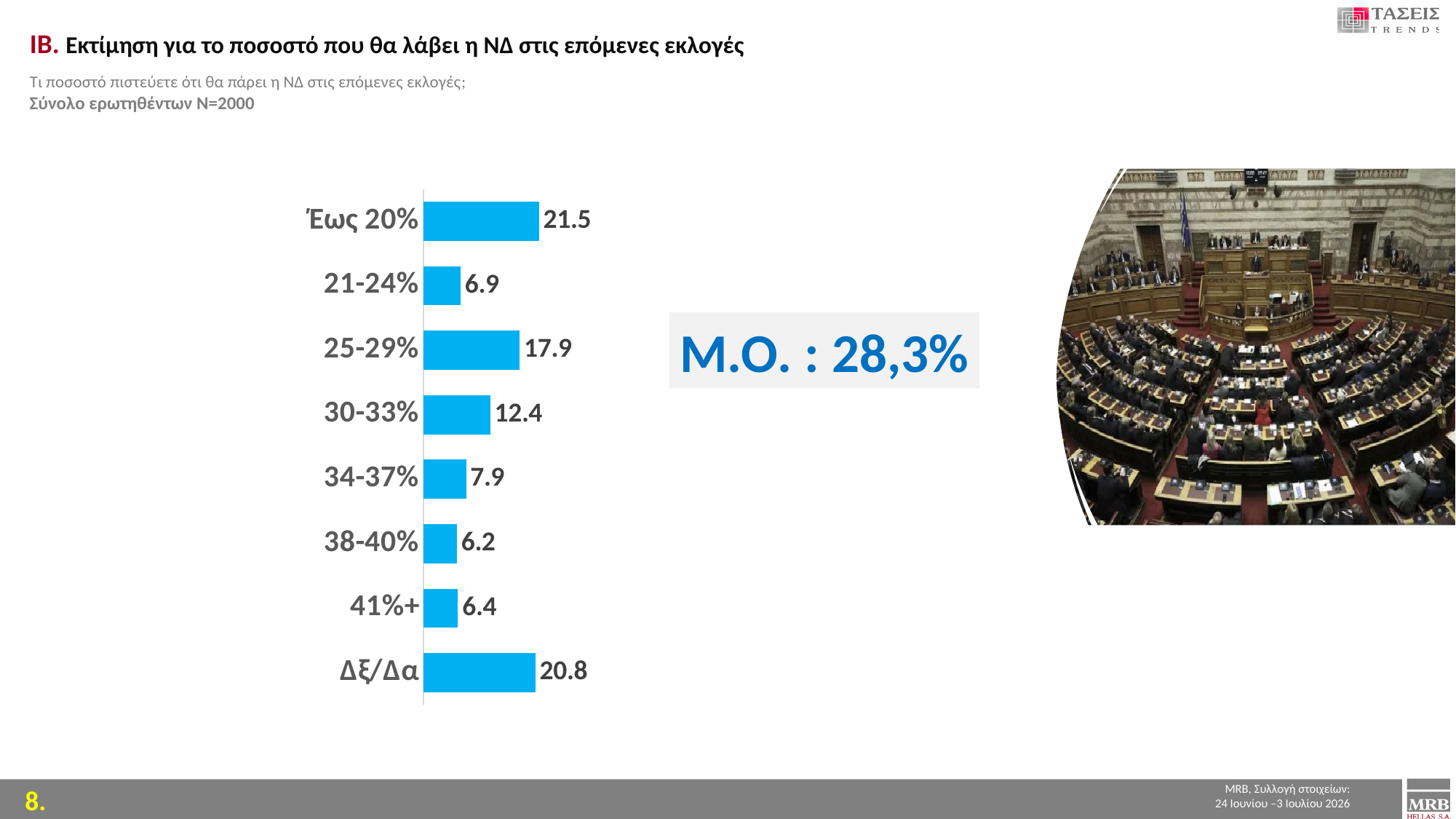
What average (Μ.Ο.) is displayed next to the chart? 28,3% Which category has the highest value? Έως 20% What is the difference between the values for '25-29%' and '30-33%'? 5.5 What is the value for the '25-29%' category? 17.9 What kind of chart is shown on the slide? Bar chart Which is larger, the value for '21-24%' or the value for '34-37%'? 34-37% Which category has the lowest value? 38-40% What is the value for the 'Έως 20%' category? 21.5 What is the difference between the values for 'Έως 20%' and 'Δξ/Δα'? 0.7 How many categories are shown in the chart? 8 What is the value for the 'Δξ/Δα' category? 20.8 What is the value for the '41%+' category? 6.4